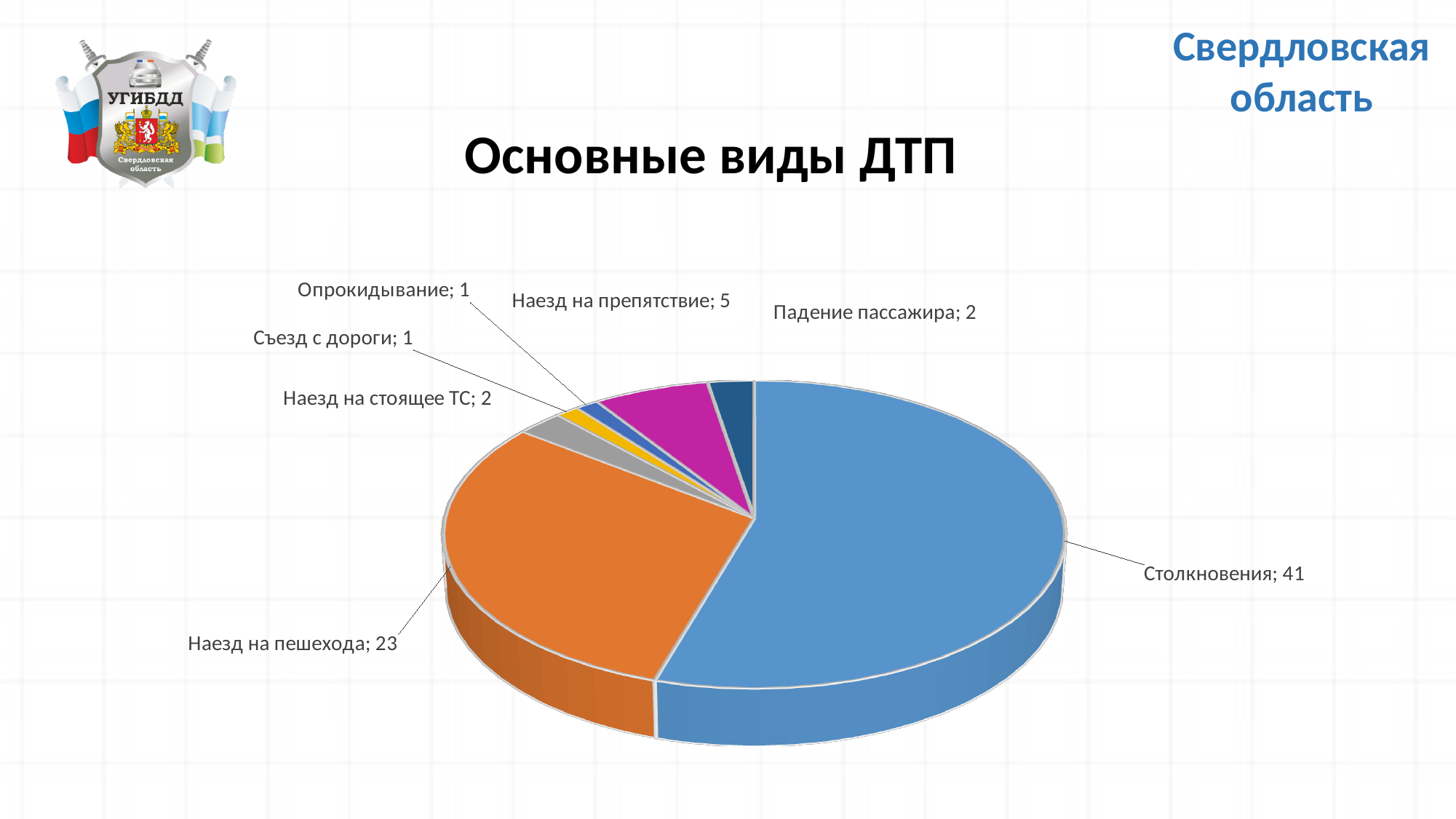
What kind of chart is shown on the slide? pie chart What is the difference between the values for Столкновения and Наезд на пешехода? 18 What is the title of the chart? Основные виды ДТП What is the value for Столкновения? 41 Which is larger, the value for Наезд на препятствие or the value for Наезд на стоящее ТС? Наезд на препятствие What is the value for Наезд на пешехода? 23 What is the value for Опрокидывание? 1 How many categories are shown in the pie chart? 7 What is the value for Наезд на препятствие? 5 What is the value for Падение пассажира? 2 Which category has the largest slice of the pie? Столкновения What is the total of all the values shown in the pie chart? 75